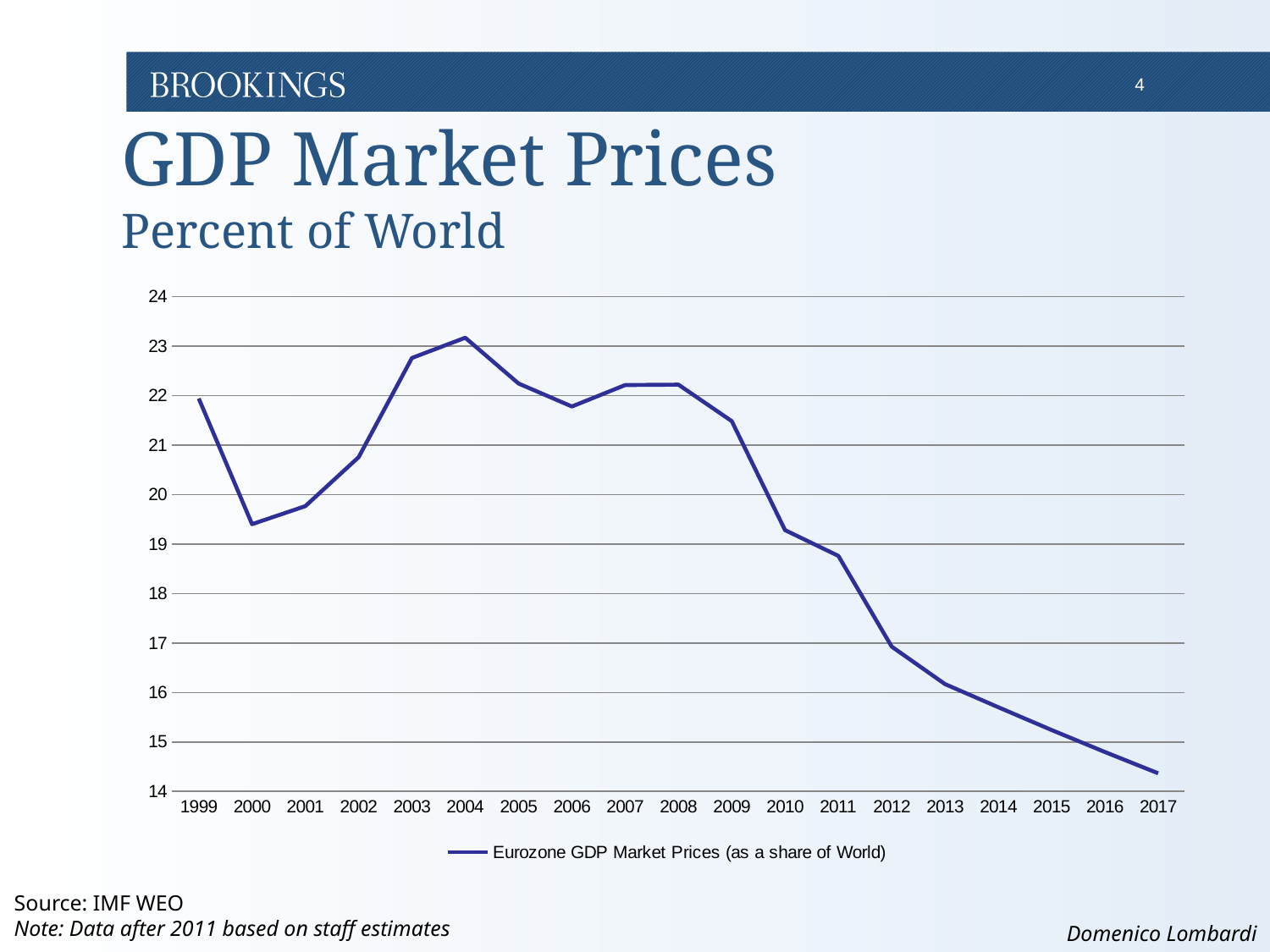
Is the value for 2012 greater or less than 18? less Which year has the larger value, 2003 or 2011? 2003 What kind of chart is shown on the slide? Line chart Is the value for 2017 greater or less than 15? less How many years are plotted along the x axis? 19 In which year is the Eurozone GDP share of world highest? 2004 Is the value for 2000 greater or less than 20? less What is the legend entry for the plotted line? Eurozone GDP Market Prices (as a share of World) Do the values rise or fall from 2008 to 2017? fall In which year is the Eurozone GDP share of world lowest? 2017 How many series does the legend list? 1